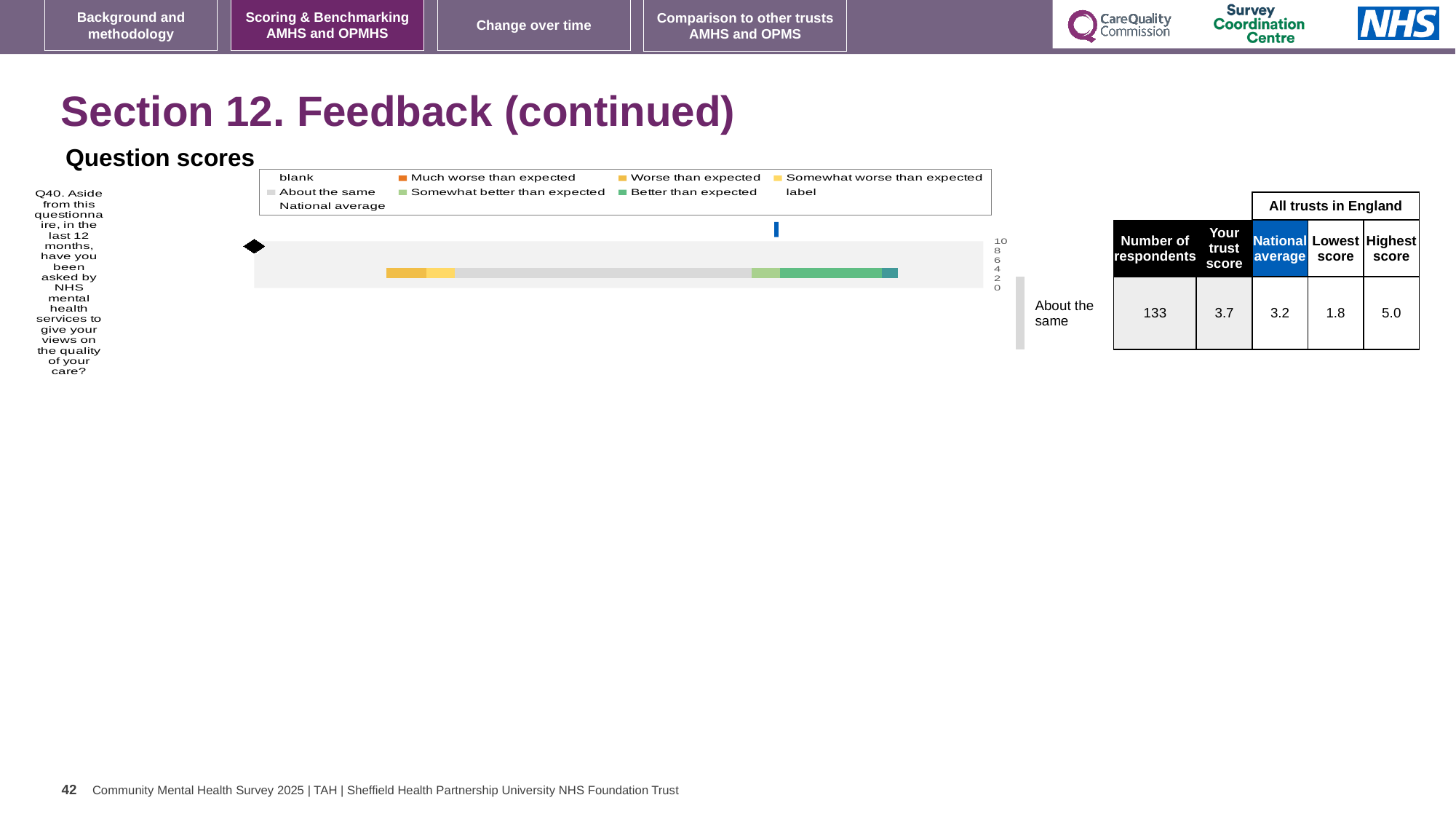
What kind of chart is shown under 'Question scores'? bar chart In the table next to the chart, what is the highest score among all trusts in England for Q40? 5.0 How many question categories are plotted in the chart? 1 In the table next to the chart, what is the lowest score among all trusts in England for Q40? 1.8 In the table next to the chart, what is the number of respondents for Q40? 133 In the table next to the chart, what is the national average for Q40? 3.2 Which legend entry is shown in grey in the chart? About the same What is the difference between the highest score and the lowest score for Q40 in the table? 3.2 Which is larger for Q40: the trust score or the national average? the trust score How many entries does the chart's legend list? 9 Which question number is plotted in the chart? Q40 In the table next to the chart, what is 'Your trust score' for Q40? 3.7